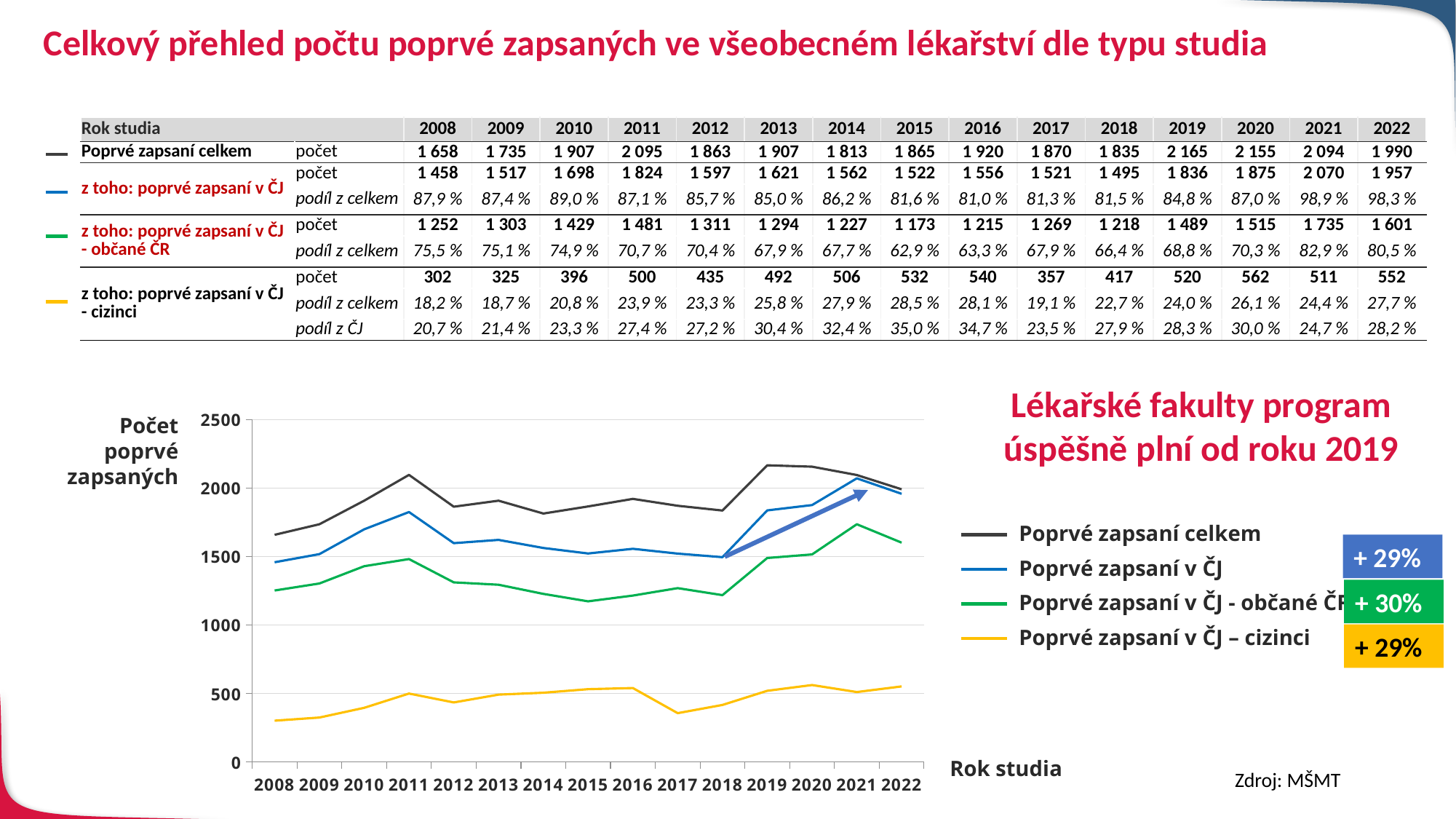
How many series does the chart legend list? 4 What colour is the line for 'Poprvé zapsaní v ČJ – cizinci'? yellow What kind of chart is shown on the slide? line chart Is the value for 'Poprvé zapsaní v ČJ – cizinci' in 2017 greater or less than 500? less Is the value for 'Poprvé zapsaní celkem' in 2011 greater or less than 2000? greater Which year has the larger value for 'Poprvé zapsaní celkem', 2011 or 2018? 2011 What is the difference between 'Poprvé zapsaní celkem' and 'Poprvé zapsaní v ČJ' in 2022? 33 In which year does the 'Poprvé zapsaní v ČJ - občané ČR' series reach its highest value? 2021 What is the value of 'Poprvé zapsaní celkem' in 2022? 1 990 What is the value of 'Poprvé zapsaní v ČJ – cizinci' in 2016? 540 In which year does the 'Poprvé zapsaní v ČJ' series reach its highest value? 2021 How many years are plotted along the x axis of the chart? 15